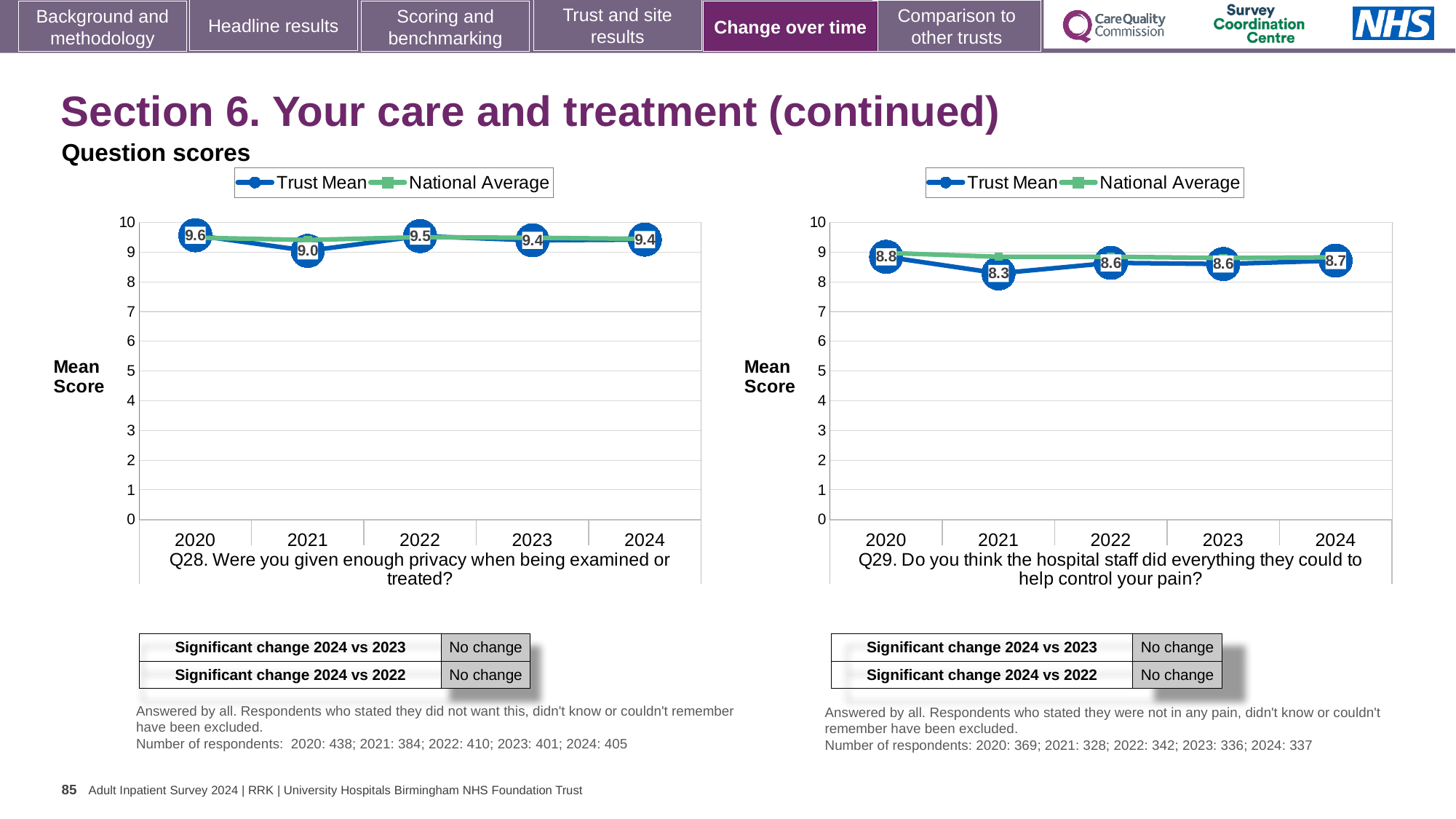
On the Q29 chart (right), is the National Average for 2021 greater or less than 8? greater How many series does the legend of the Q29 chart (right) list? 2 On the Q28 chart (left), what is the Trust Mean for 2021? 9.0 On the Q28 chart (left), which year has the lowest Trust Mean? 2021 On the Q28 chart (left), which year has the highest Trust Mean? 2020 On the Q29 chart (right), which year has the lowest Trust Mean? 2021 On the Q28 chart (left), what is the Trust Mean for 2020? 9.6 How many years are shown on the x axis of the Q28 chart (left)? 5 On the Q29 chart (right), what is the Trust Mean for 2021? 8.3 On the Q28 chart (left), what is the difference between the Trust Mean in 2020 and in 2021? 0.6 On the Q29 chart (right), what is the Trust Mean for 2024? 8.7 On the Q29 chart (right), is the Trust Mean for 2020 or for 2021 larger? 2020